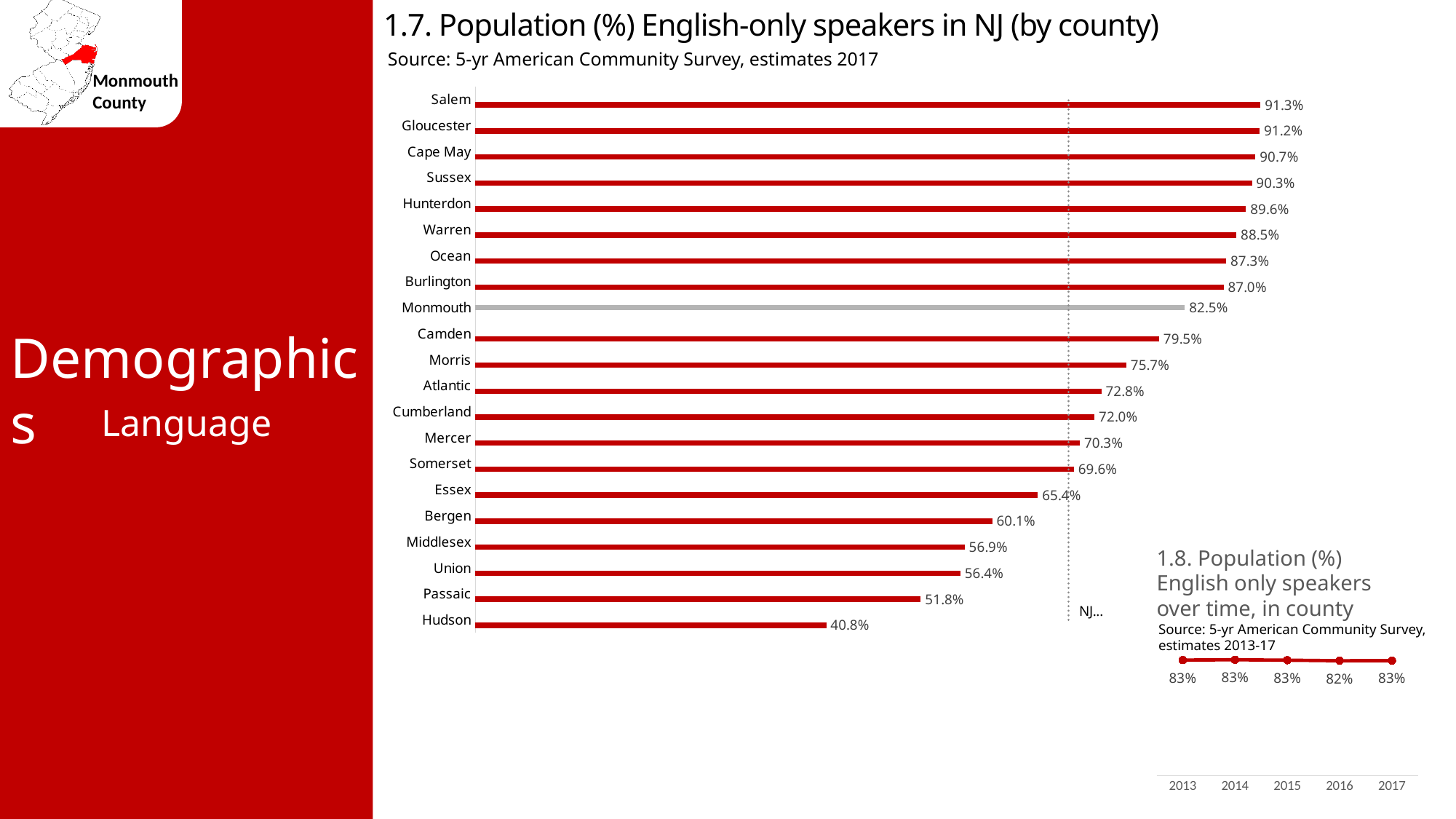
In chart 1.8, how many years are plotted? 5 In chart 1.7, how many counties are shown? 21 In chart 1.7, which is larger, the value for Camden or the value for Morris? Camden In chart 1.7, what is the value for Monmouth? 82.5% In chart 1.7, which county's bar is shown in grey rather than red? Monmouth In chart 1.8, what is the value for 2016? 82% In chart 1.7, what is the difference between the values for Salem and Hudson? 50.5% In chart 1.7, which county has the highest percentage of English-only speakers? Salem In chart 1.7, what is the value for Hudson? 40.8% What kind of chart is chart 1.7? Bar chart In chart 1.7, what is the difference between the values for Monmouth and Burlington? 4.5% In chart 1.7, which county has the lowest percentage of English-only speakers? Hudson